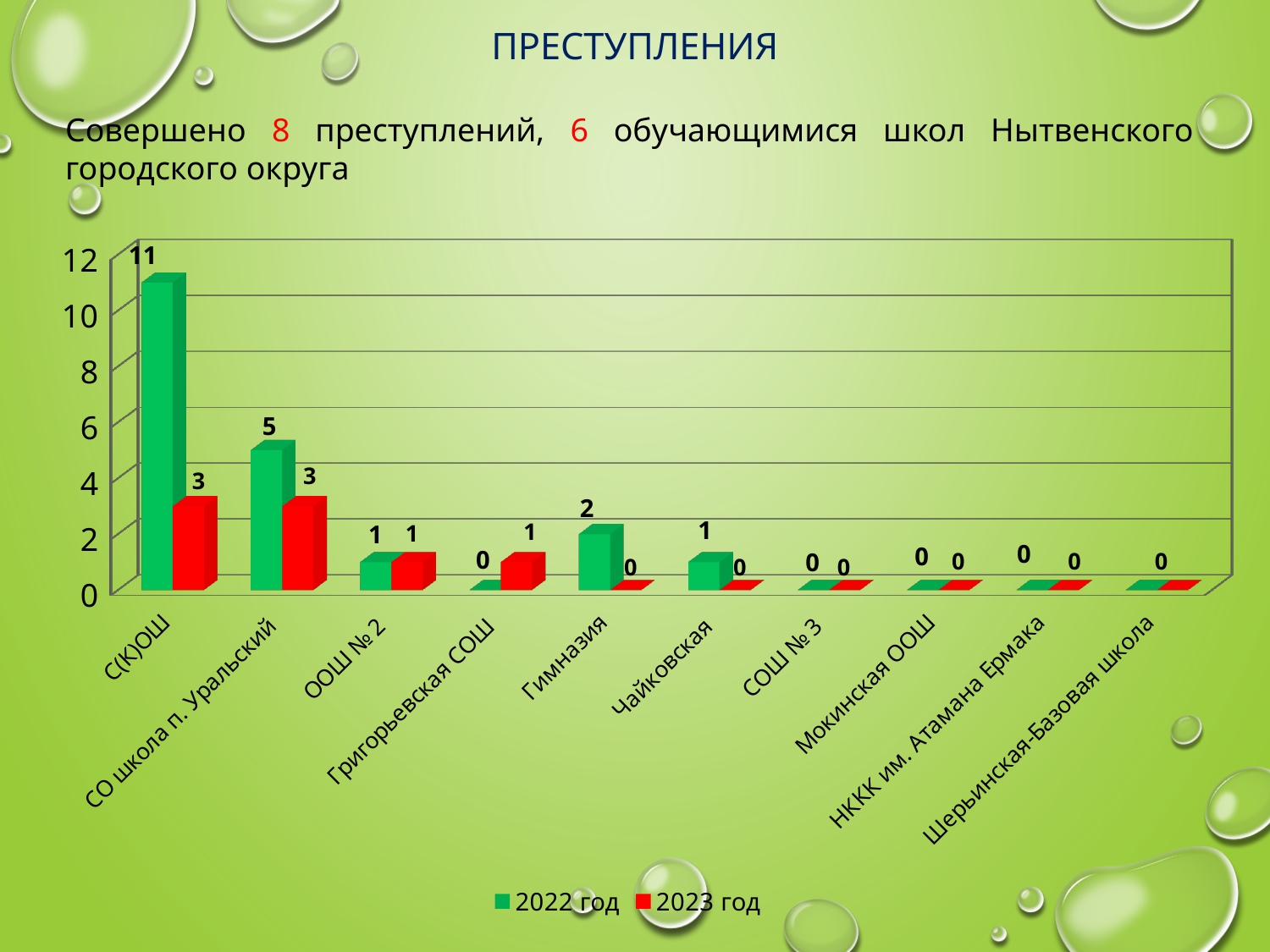
How many categories are shown on the x axis? 10 Which category has the highest value in the 2022 год series? С(К)ОШ How many series does the legend list? 2 Which is larger for СО школа п. Уральский: the 2022 год value or the 2023 год value? 2022 год Which colour represents the 2023 год series? Red What is the value for Гимназия in the 2022 год series? 2 What is the value for Григорьевская СОШ in the 2023 год series? 1 What is the value for С(К)ОШ in the 2022 год series? 11 What is the value for СО школа п. Уральский in the 2023 год series? 3 What is the title of the slide? ПРЕСТУПЛЕНИЯ What kind of chart is shown on the slide? Bar chart What is the difference between the 2022 год and 2023 год values for С(К)ОШ? 8